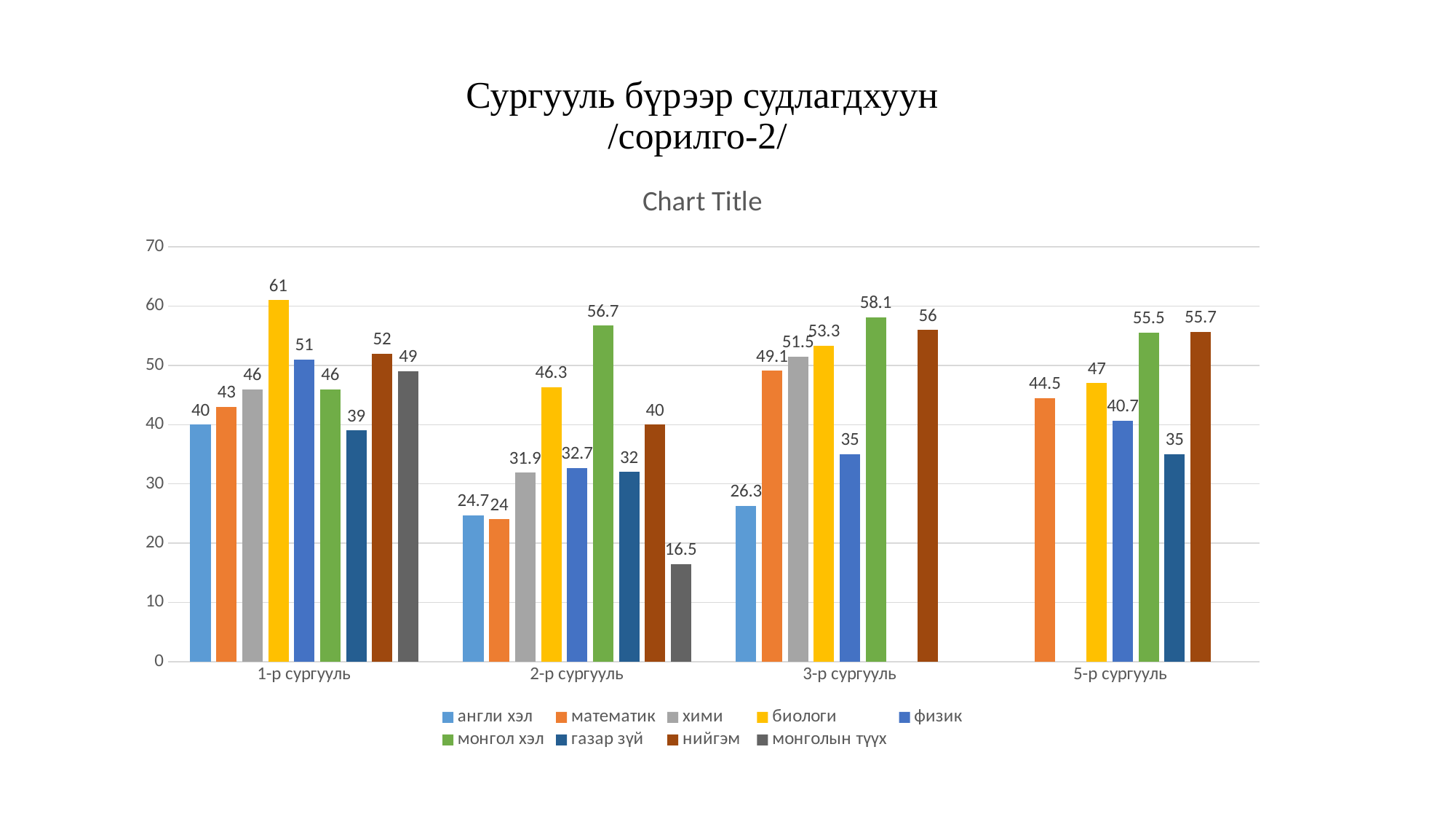
How many series does the legend list? 9 What is the value for нийгэм at 5-р сургууль? 55.7 Which series has the lowest value at 2-р сургууль? монголын түүх Which is larger at 3-р сургууль: монгол хэл or нийгэм? монгол хэл What is the value for биологи at 1-р сургууль? 61 Which series has the highest value at 1-р сургууль? биологи What is the difference between биологи and математик at 1-р сургууль? 18 Is the value for физик at 5-р сургууль greater or less than 50? less What kind of chart is shown on the slide? bar chart What is the value for англи хэл at 3-р сургууль? 26.3 What is the value for монгол хэл at 2-р сургууль? 56.7 How many school categories are shown on the x axis? 4